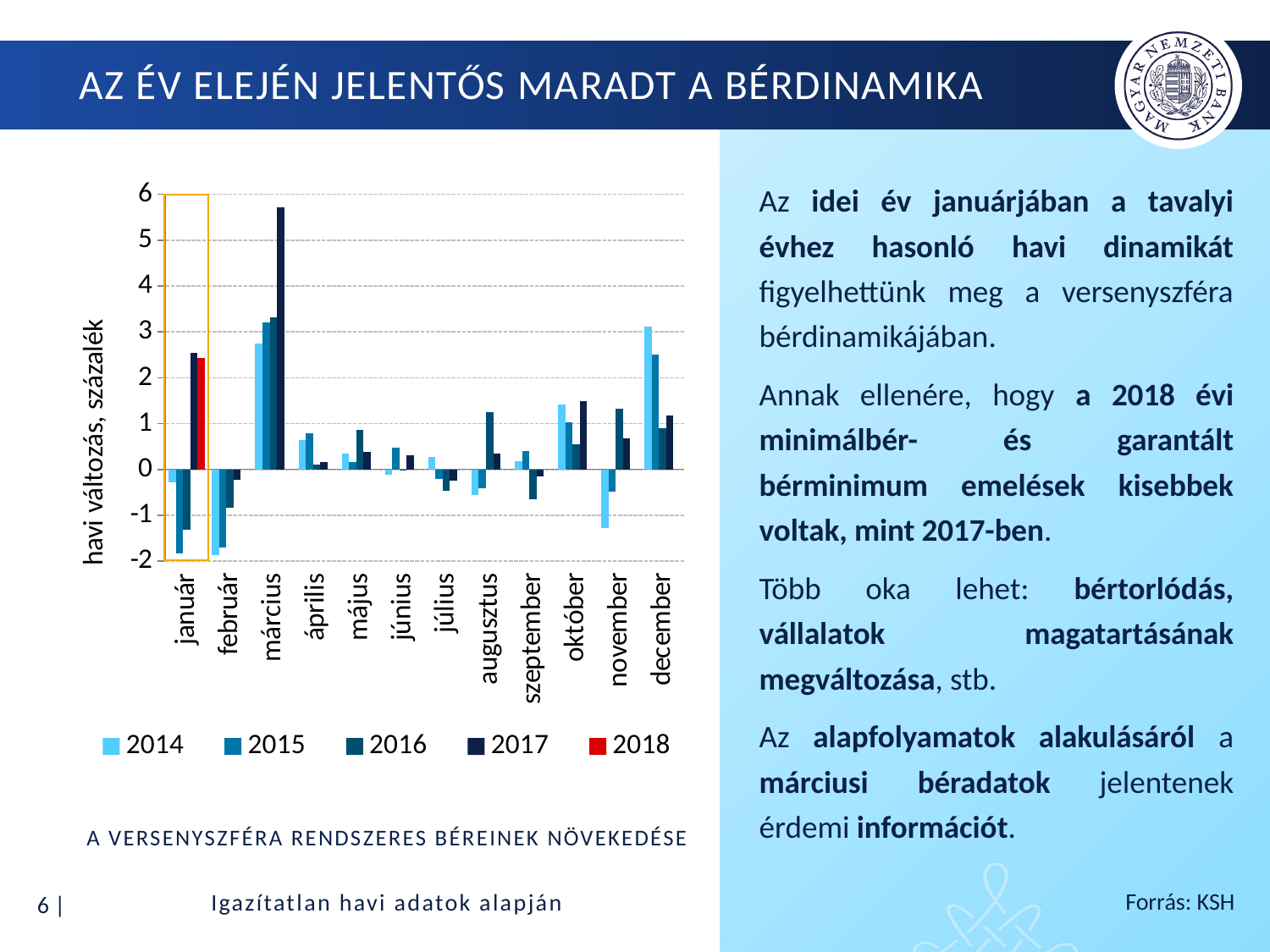
Is the 2016 value for január greater or less than -1? less What is the label of the chart's vertical axis? havi változás, százalék What kind of chart is shown on the slide? bar chart Which month has the highest value for the 2017 series? március Is the 2014 value for november greater or less than -1? less How many series does the chart's legend list? 5 Is the 2017 value for március greater or less than 5? greater How many months (categories) are shown on the x axis of the chart? 12 For március, which series has the larger value: 2014 or 2017? 2017 Which month is highlighted with an orange box on the chart? január